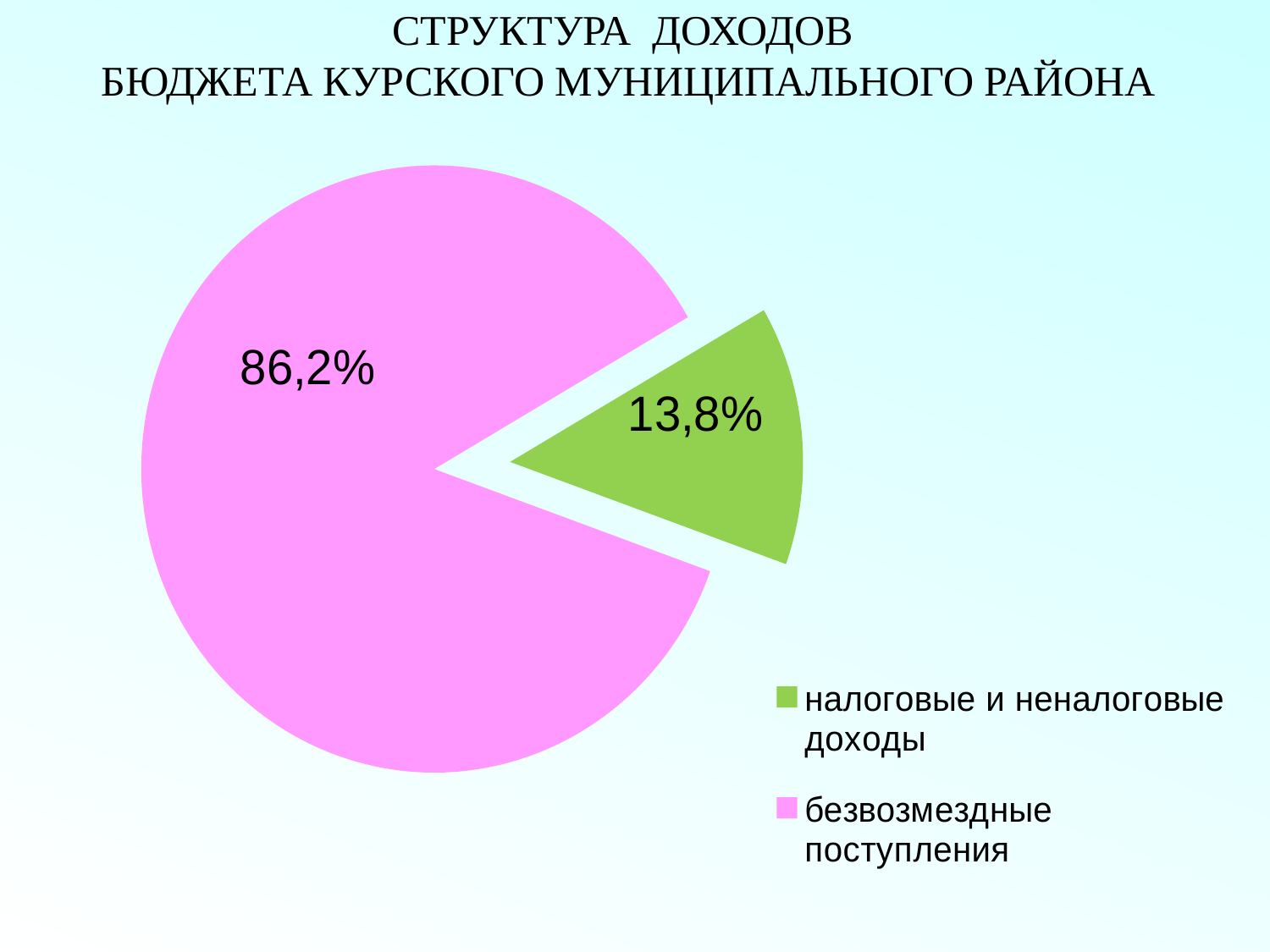
What colour is the slice for 'налоговые и неналоговые доходы'? green What is the difference in percentage points between 'безвозмездные поступления' and 'налоговые и неналоговые доходы'? 72,4 What is the title of the slide? СТРУКТУРА ДОХОДОВ БЮДЖЕТА КУРСКОГО МУНИЦИПАЛЬНОГО РАЙОНА What share of the pie does 'безвозмездные поступления' take? 86,2% What kind of chart is shown on the slide? pie chart Which category has the largest slice of the pie? безвозмездные поступления How many entries does the legend list? 2 How many categories are shown in the pie chart? 2 Which is larger: 'налоговые и неналоговые доходы' or 'безвозмездные поступления'? безвозмездные поступления Which category has the smallest slice of the pie? налоговые и неналоговые доходы What share of the pie does 'налоговые и неналоговые доходы' take? 13,8%